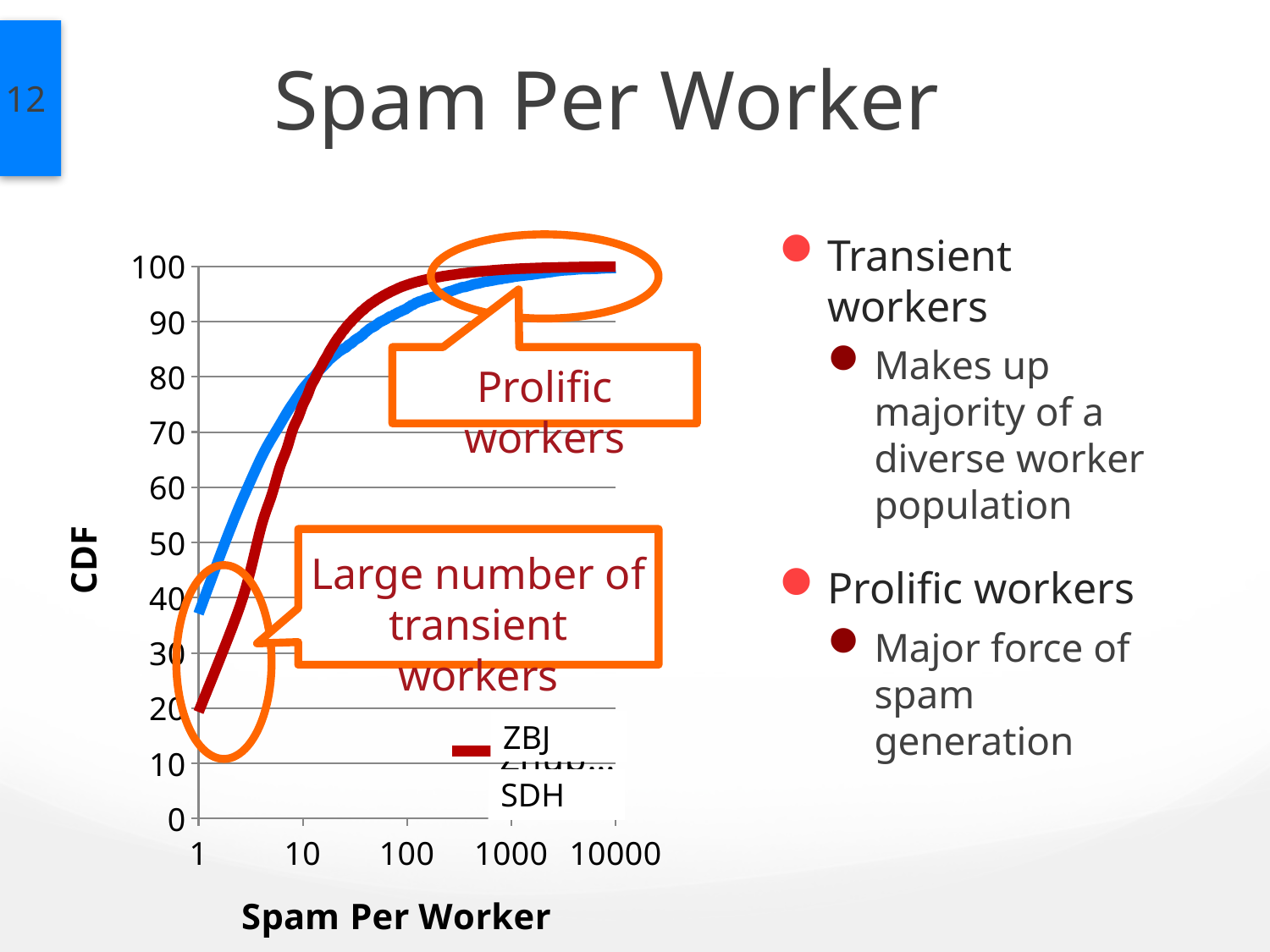
Do the CDF values for SDH rise or fall as Spam Per Worker increases along the x axis? rise What is the label of the chart's y axis? CDF At Spam Per Worker = 1, is the CDF value for ZBJ greater or less than 30? less Do the CDF values for ZBJ rise or fall as Spam Per Worker increases along the x axis? rise At Spam Per Worker = 1, is the CDF value for SDH greater or less than 30? greater How many tick labels are shown on the chart's x axis? 5 How many series does the chart's legend list? 2 Which two series are listed in the chart's legend? ZBJ and SDH At Spam Per Worker = 100, which series has the higher CDF value, ZBJ or SDH? ZBJ At Spam Per Worker = 100, is the CDF value for ZBJ greater or less than 90? greater What kind of chart is shown on the slide? line chart At Spam Per Worker = 1, which series has the higher CDF value, ZBJ or SDH? SDH